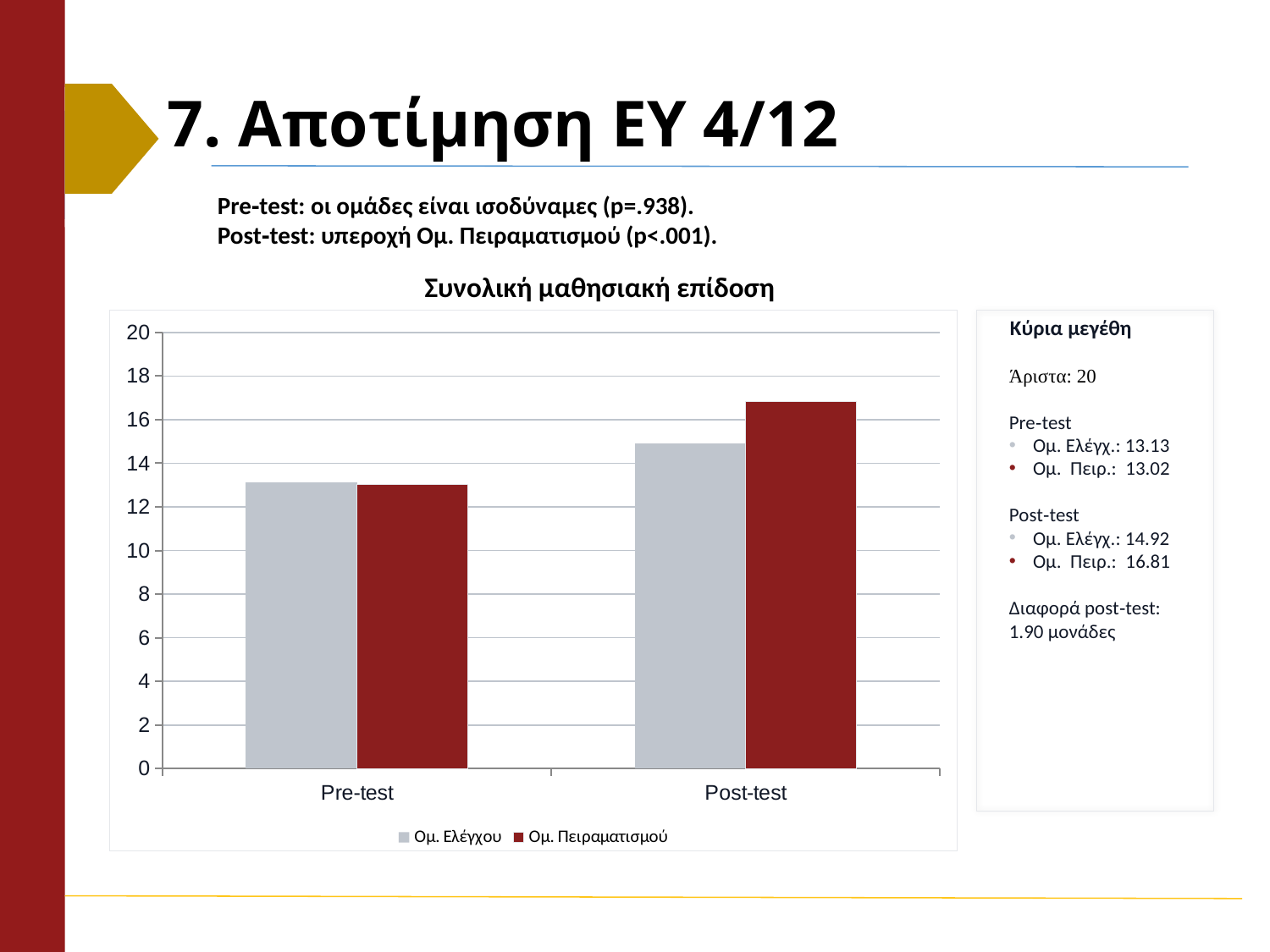
How many categories are shown on the x axis of the chart? 2 What kind of chart is shown on the slide? bar chart What is the title of the chart? Συνολική μαθησιακή επίδοση In the Post-test category, which series has the larger value? Ομ. Πειραματισμού Does the value for Ομ. Πειραματισμού rise or fall from Pre-test to Post-test? rise What is the Pre-test value for Ομ. Πειραματισμού? 13.02 What is the Post-test value for Ομ. Ελέγχου? 14.92 What is the Pre-test value for Ομ. Ελέγχου? 13.13 How many series does the chart legend list? 2 What is the difference between the Post-test values of Ομ. Πειραματισμού and Ομ. Ελέγχου? 1.90 Is the Post-test value for Ομ. Πειραματισμού greater or less than 16? greater What is the Post-test value for Ομ. Πειραματισμού? 16.81